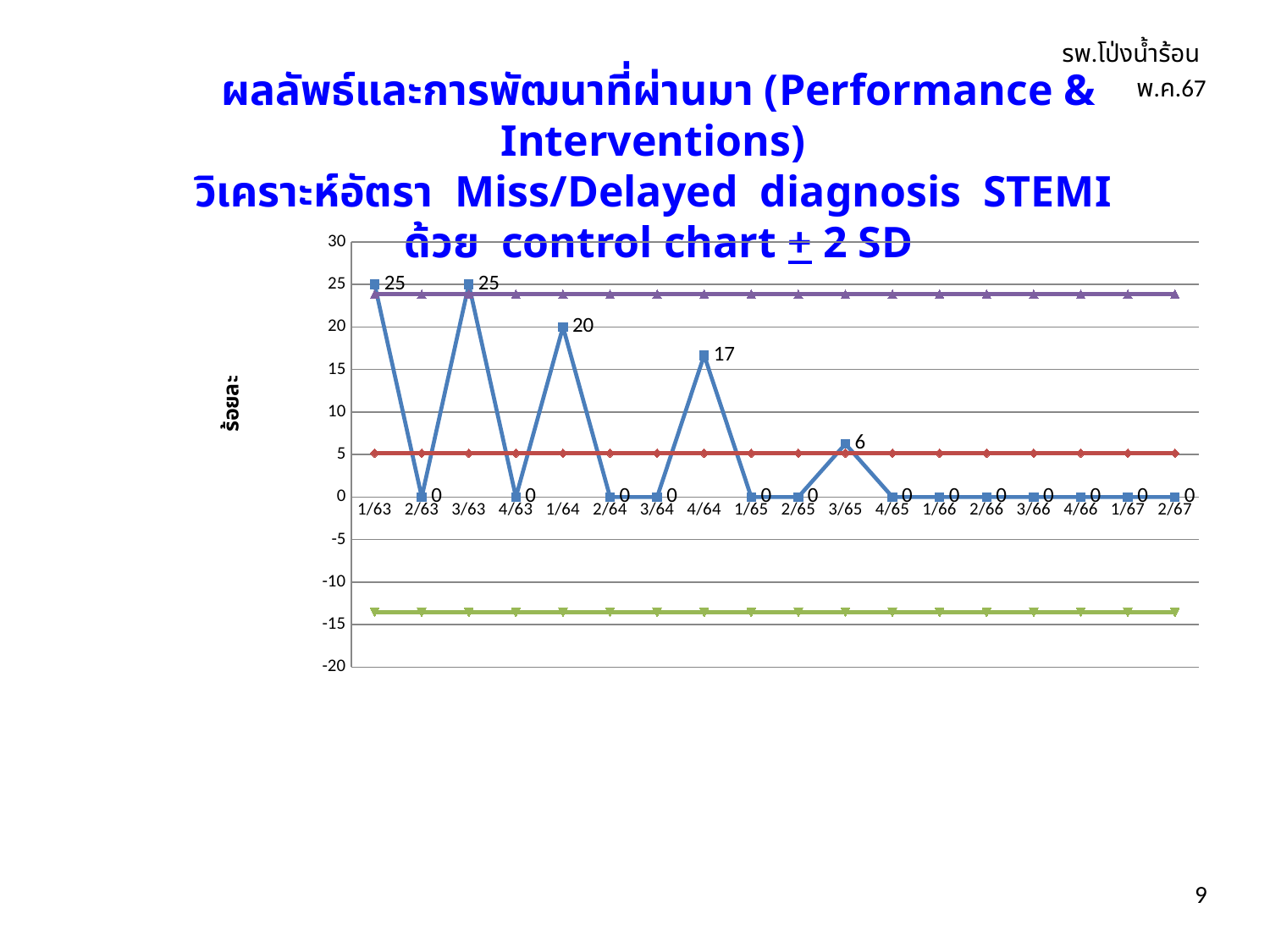
What is the difference between the values for 1/63 and 3/65? 19 What is the value for 4/64? 17 What kind of chart is shown on the slide? line chart What is the label on the vertical axis? ร้อยละ Is the upper control limit line greater or less than 20? greater How many time periods are shown on the x axis? 18 What is the difference between the values for 1/64 and 4/64? 3 What is the value for 3/65? 6 Which is larger, the value for 4/64 or the value for 3/65? 4/64 What is the value for 1/64? 20 What is the value for 2/67? 0 What is the highest value plotted on the data line? 25